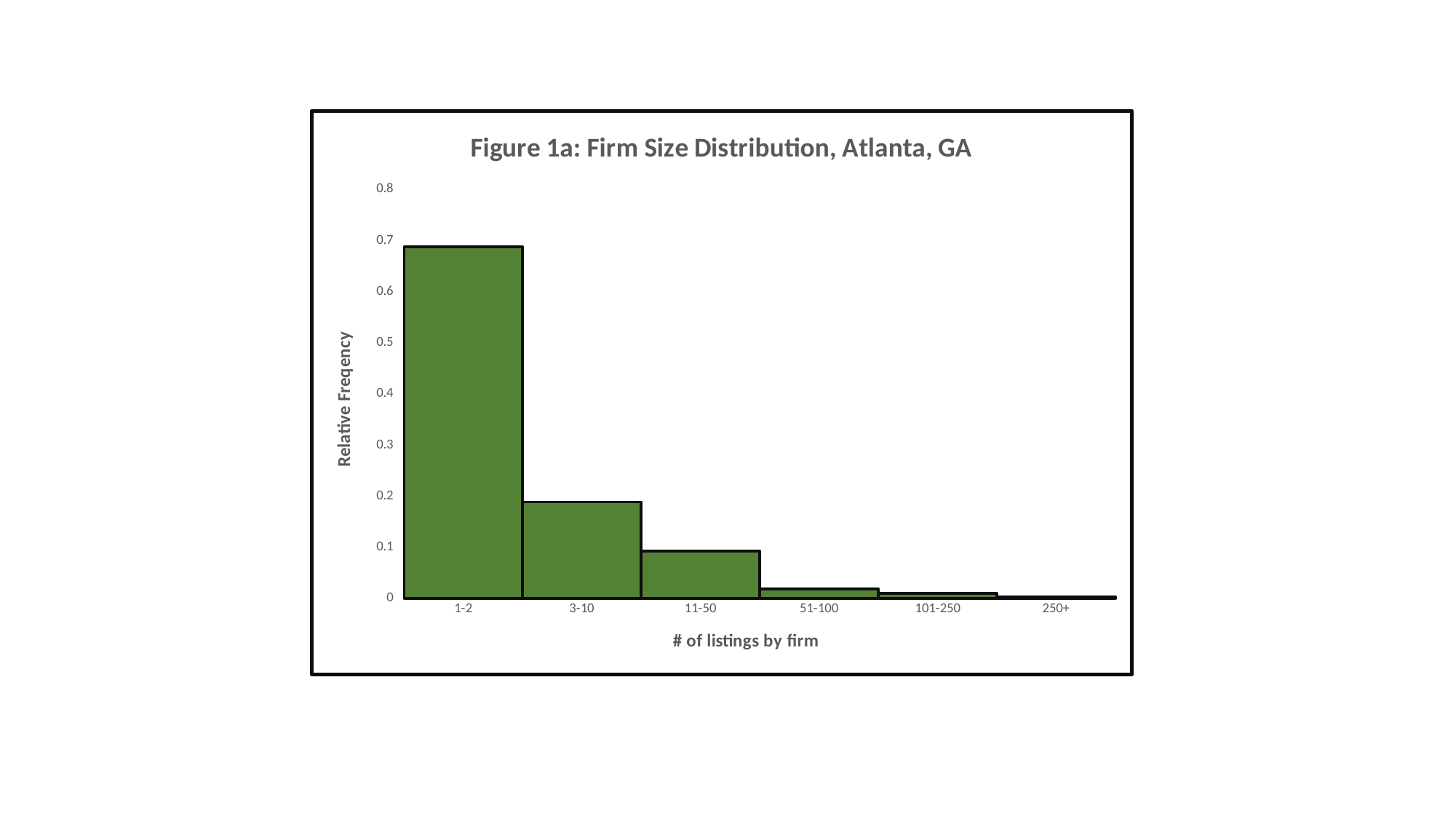
Do the relative frequencies rise or fall as the number of listings by firm increases along the x axis? fall What is the label on the x axis of the chart? # of listings by firm How many firm-size categories are shown on the x axis? 6 What kind of chart is shown on the slide? bar chart Is the relative frequency for the 3-10 category greater or less than 0.2? less Is the relative frequency for the 51-100 category greater or less than 0.1? less Is the relative frequency for the 3-10 category greater or less than 0.1? greater Which has a higher relative frequency, the 3-10 category or the 11-50 category? 3-10 Which firm-size category has the highest relative frequency? 1-2 What is the title of the chart? Figure 1a: Firm Size Distribution, Atlanta, GA